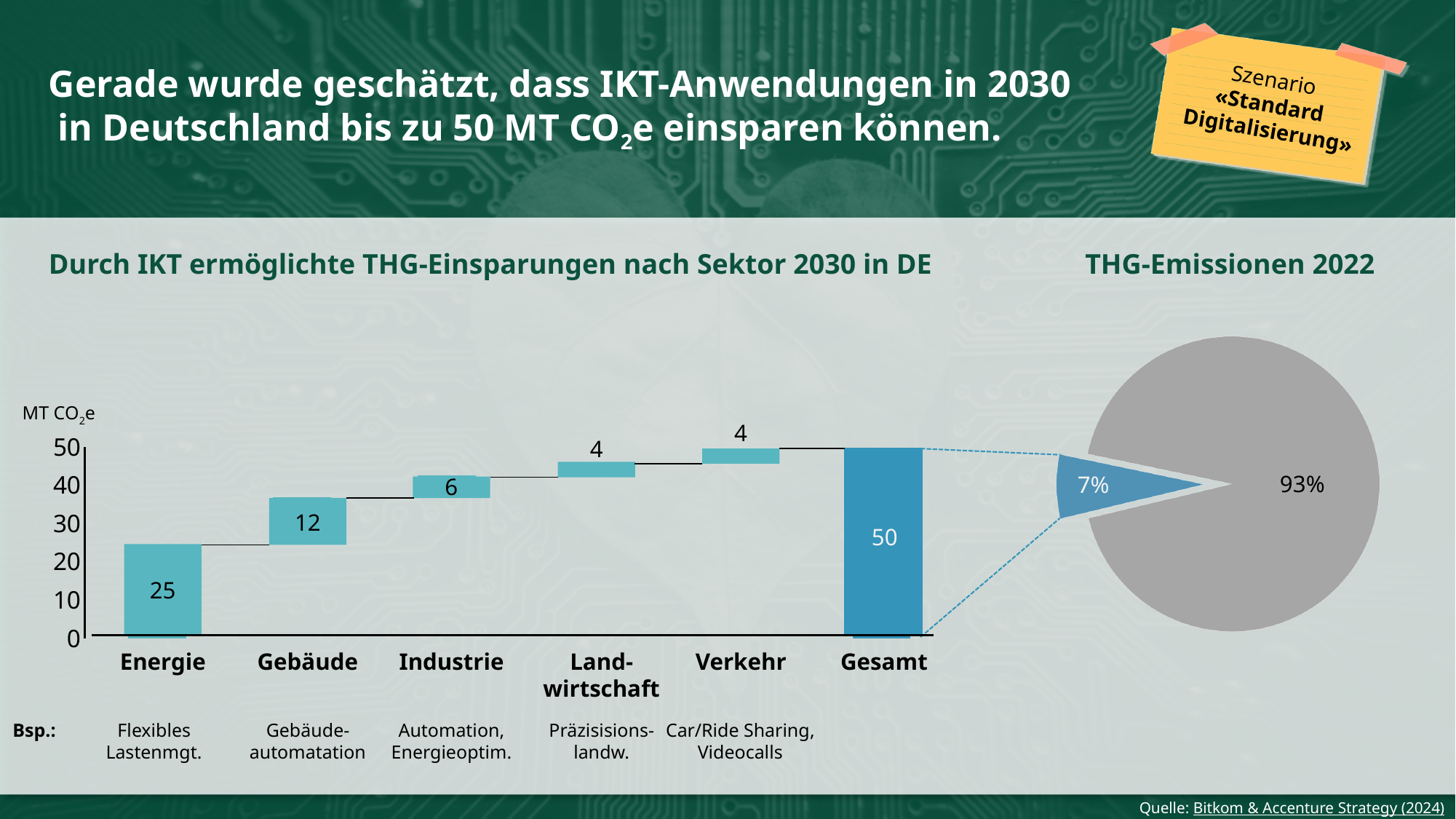
In the chart 'Durch IKT ermöglichte THG-Einsparungen nach Sektor 2030 in DE', what is the value for Industrie? 6 In the chart 'Durch IKT ermöglichte THG-Einsparungen nach Sektor 2030 in DE', what is the difference between the values for Energie and Gebäude? 13 In the chart 'Durch IKT ermöglichte THG-Einsparungen nach Sektor 2030 in DE', which sector has the highest savings? Energie In the chart 'Durch IKT ermöglichte THG-Einsparungen nach Sektor 2030 in DE', what is the value shown for Gesamt? 50 In the chart 'THG-Emissionen 2022', what share does the blue slice represent? 7% In the chart 'Durch IKT ermöglichte THG-Einsparungen nach Sektor 2030 in DE', what unit is shown on the y axis? MT CO2e What kind of chart is 'THG-Emissionen 2022'? Pie chart In the chart 'Durch IKT ermöglichte THG-Einsparungen nach Sektor 2030 in DE', how many sector categories are shown on the x axis, including Gesamt? 6 In the chart 'Durch IKT ermöglichte THG-Einsparungen nach Sektor 2030 in DE', what is the value for Gebäude? 12 In the chart 'Durch IKT ermöglichte THG-Einsparungen nach Sektor 2030 in DE', what is the value for Energie? 25 In the chart 'Durch IKT ermöglichte THG-Einsparungen nach Sektor 2030 in DE', which is larger, the value for Gebäude or the value for Industrie? Gebäude In the chart 'THG-Emissionen 2022', what share does the grey slice represent? 93%